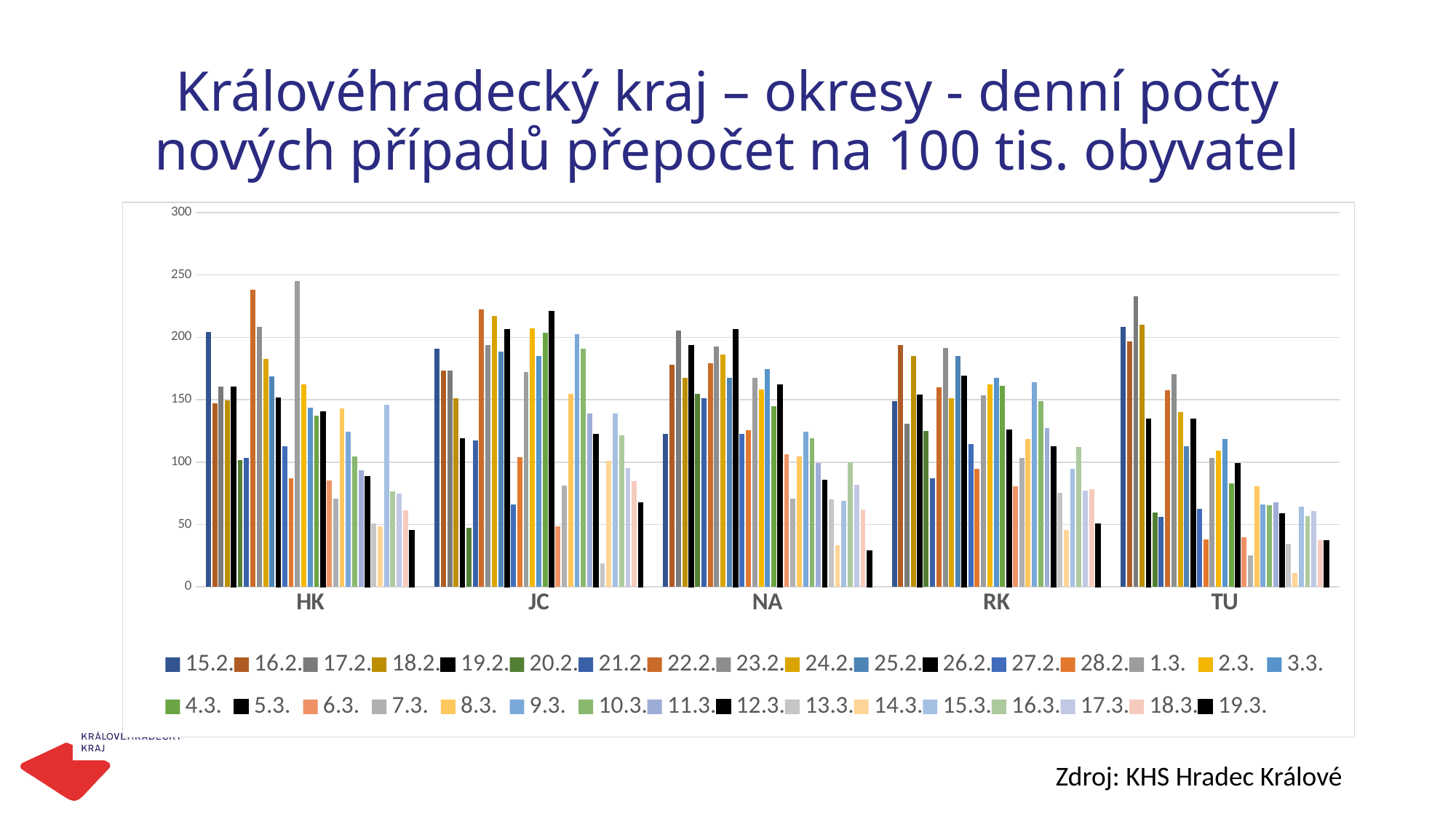
What kind of chart is shown on the slide? bar chart How many categories (districts) are shown on the x axis of the chart? 5 Is the value of the first bar (15.2.) for NA greater or less than 100? greater Is the value of the last bar (19.3.) for NA greater or less than 50? less What is the highest value shown on the chart's vertical axis? 300 Is the value of the first bar (15.2.) for TU greater or less than 200? greater Which category contains the tallest bar in the chart? HK What is the first series listed in the chart's legend? 15.2. How many series does the chart's legend list? 33